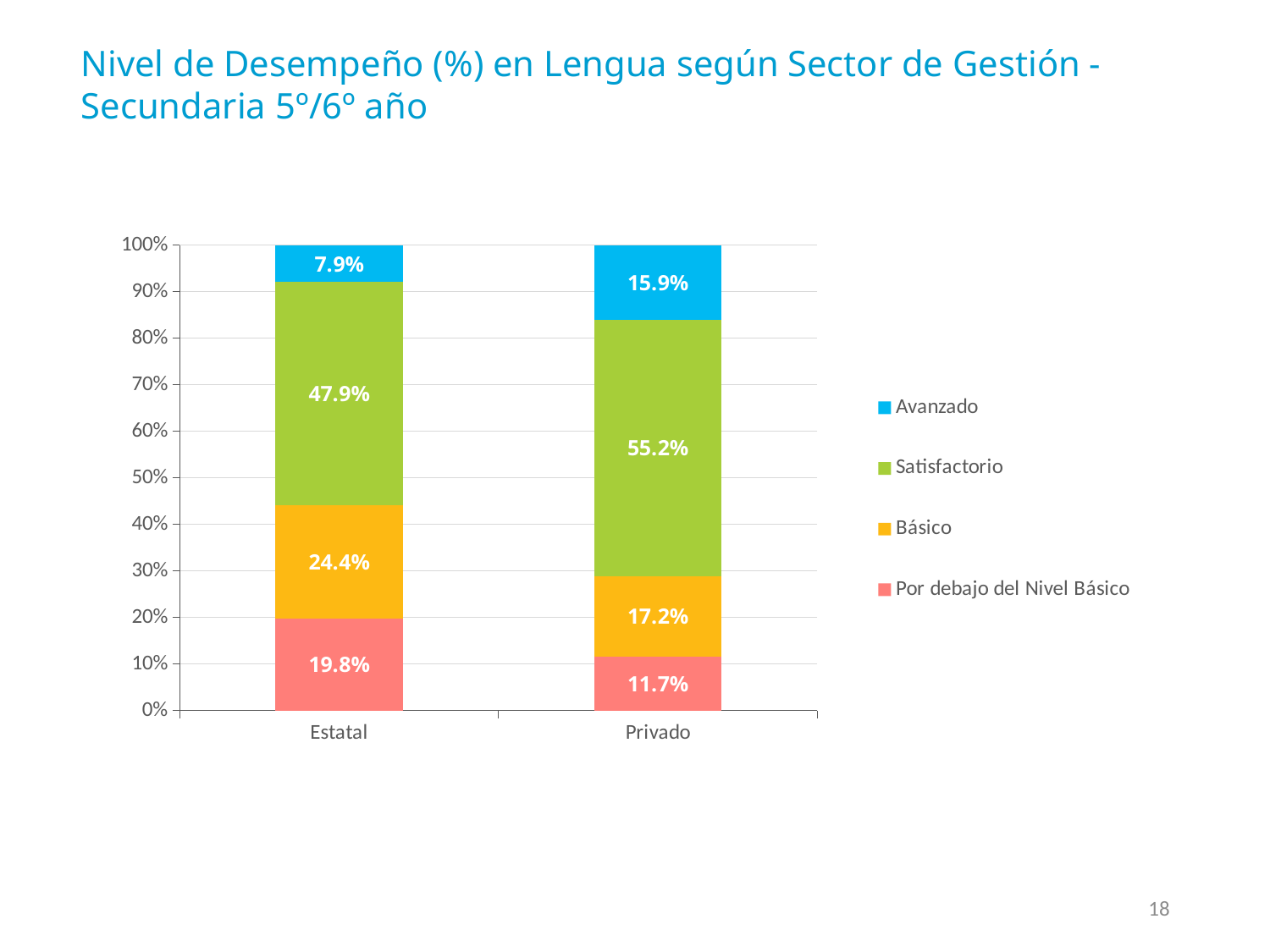
What is the Básico value for Estatal? 24.4% What is the Satisfactorio value for Estatal? 47.9% Which performance level has the smallest share within the Estatal bar? Avanzado What is the difference between the Satisfactorio values for Privado and Estatal? 7.3% Which performance level has the largest share within the Privado bar? Satisfactorio What is the difference between the Básico values for Estatal and Privado? 7.2% How many series does the legend list? 4 Which sector has the higher Por debajo del Nivel Básico value? Estatal What is the Por debajo del Nivel Básico value for Privado? 11.7% What kind of chart is shown on the slide? Stacked bar chart What is the Avanzado value for Privado? 15.9% Which sector has the higher Avanzado value? Privado